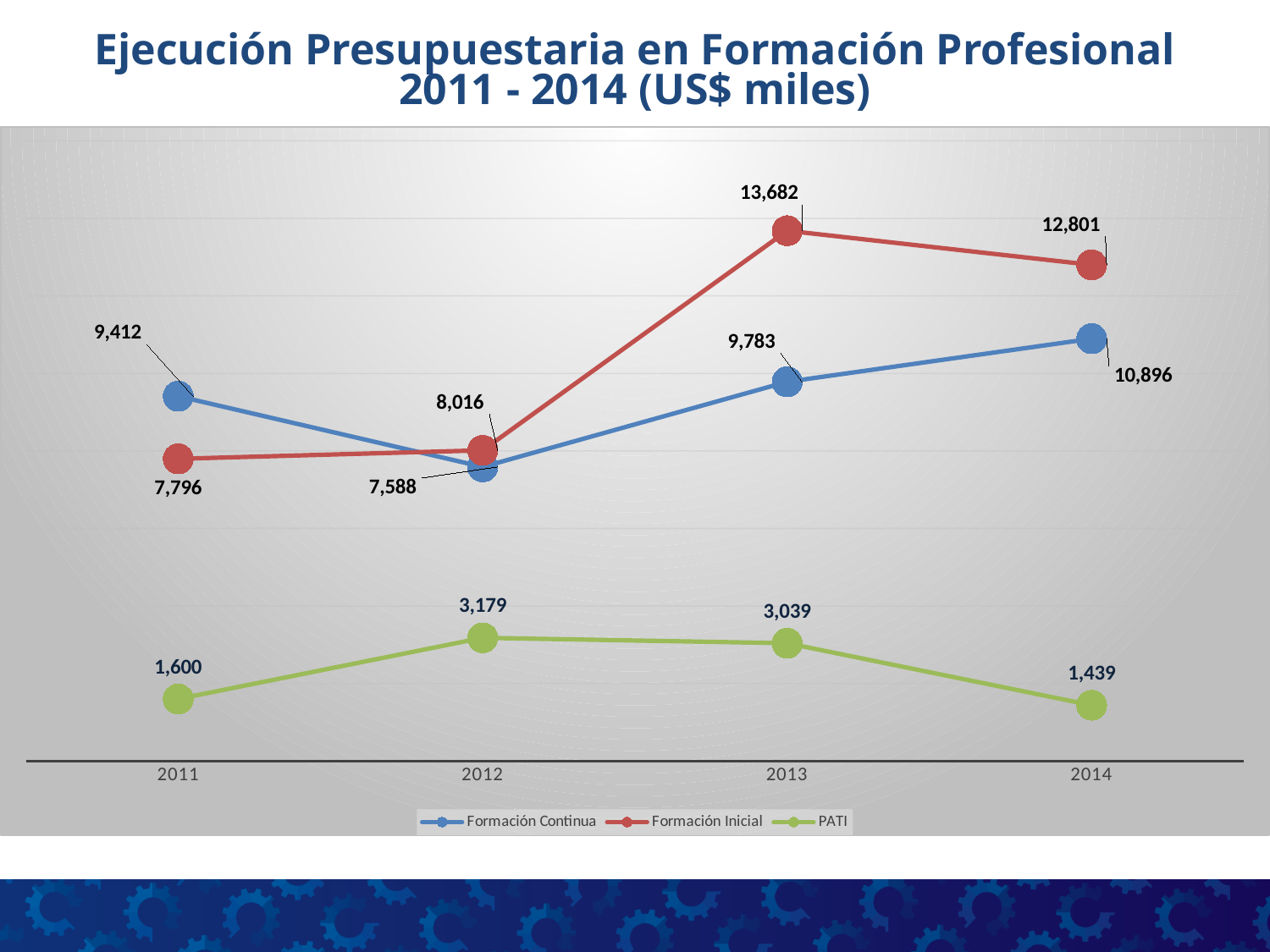
Does the PATI value rise or fall from 2013 to 2014? Fall In which year is Formación Continua lowest? 2012 What is the value for Formación Inicial in 2013? 13,682 What is the value for Formación Continua in 2014? 10,896 By how much did PATI increase from 2011 to 2012? 1,579 What kind of chart is shown on the slide? Line chart In 2011, which is larger: Formación Continua or Formación Inicial? Formación Continua In which year is Formación Inicial highest? 2013 What is the difference between Formación Inicial and Formación Continua in 2013? 3,899 How many series does the legend list? 3 What is the value for PATI in 2012? 3,179 How many years are shown on the x axis? 4